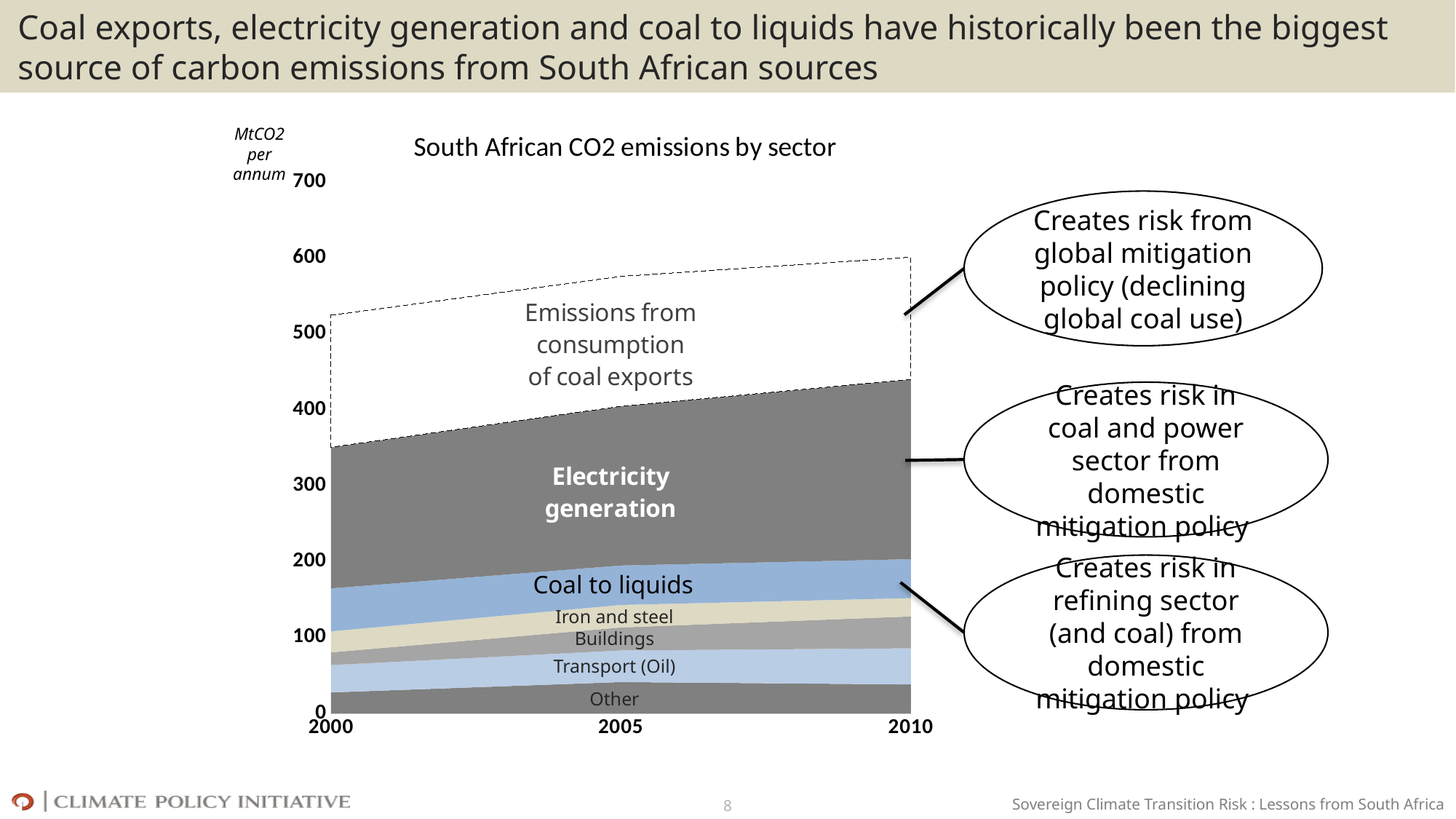
What is the title of the chart? South African CO2 emissions by sector What unit is shown on the y axis of the chart? MtCO2 per annum Which band is larger in the chart, Electricity generation or Transport (Oil)? Electricity generation What kind of chart is shown on the slide? Stacked area chart Which sector forms the largest band in the chart? Electricity generation Is the cumulative top of the Electricity generation band in 2000 greater or less than 400? less Is the total of all emissions including coal exports in 2010 greater or less than 500? greater What is the highest value shown on the y axis of the chart? 700 How many sectors (bands) are labelled in the chart, including emissions from consumption of coal exports? 7 Is the cumulative top of the Electricity generation band in 2010 greater or less than 400? greater Do total South African CO2 emissions rise or fall from 2000 to 2010 in the chart? Rise